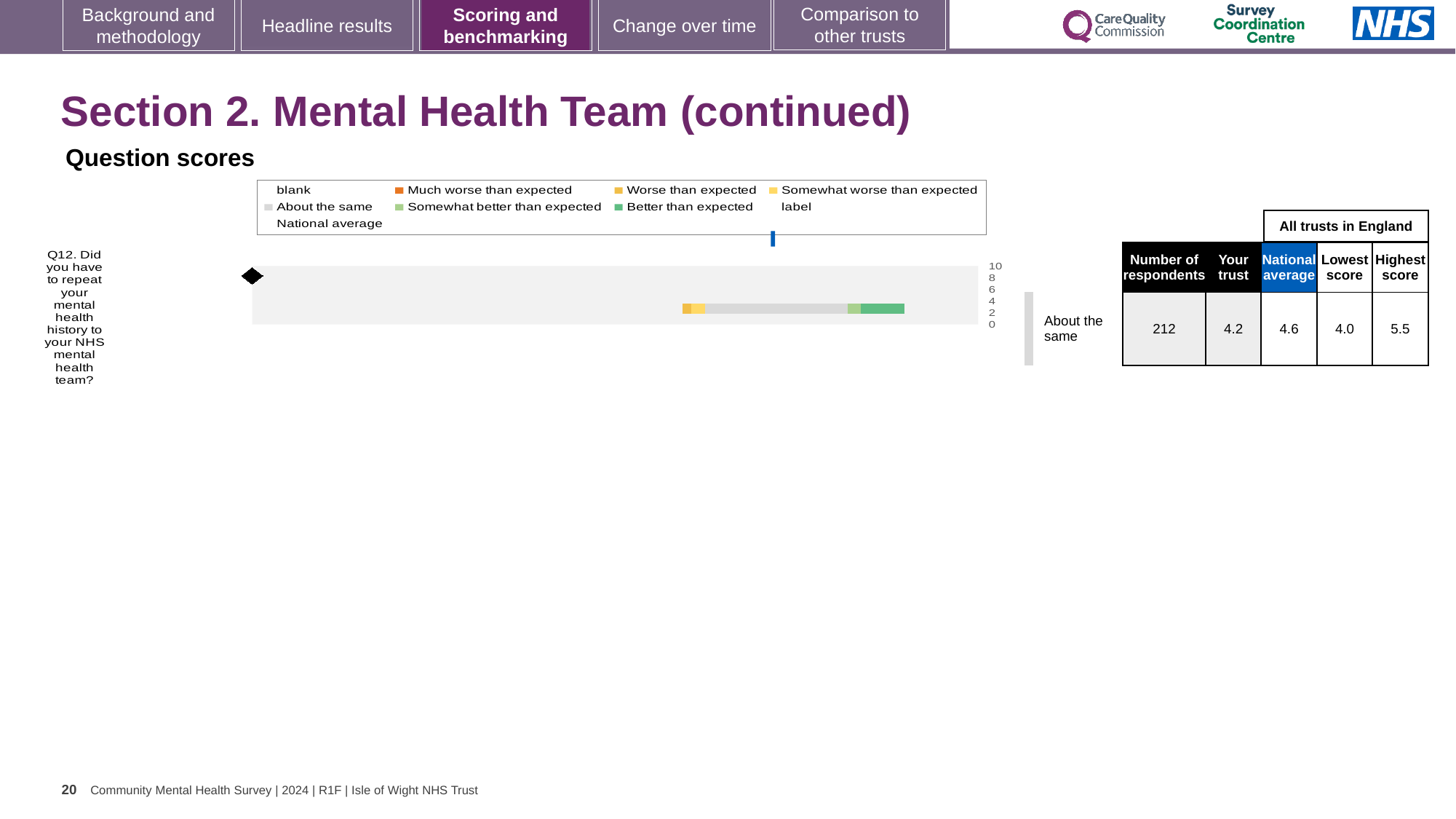
What is the national average score for Q12? 4.6 What kind of chart is used to show the Q12 benchmarking result? Bar chart What is the difference between the highest score and the lowest score for Q12? 1.5 How many respondents answered Q12? 212 How many questions are plotted on the chart? 1 Which is larger for Q12: the 'Your trust' score or the national average? National average What is the 'Your trust' score for Q12 (Did you have to repeat your mental health history to your NHS mental health team?)? 4.2 What benchmark category is the trust's Q12 result assigned to? About the same What is the highest score among all trusts in England for Q12? 5.5 Which question number is shown on the chart? Q12 By how much does the national average exceed the 'Your trust' score for Q12? 0.4 What is the lowest score among all trusts in England for Q12? 4.0